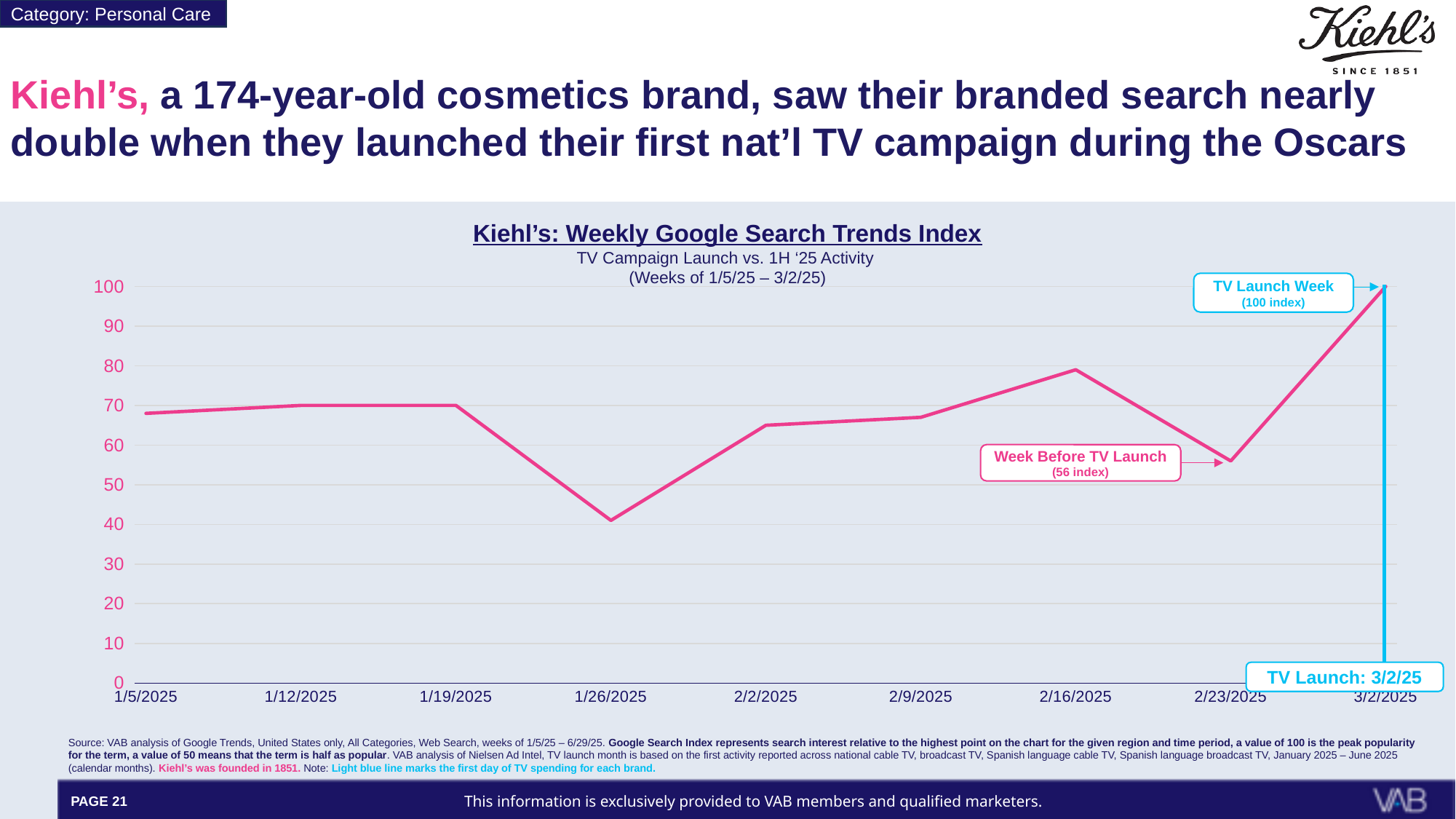
How many weekly data points are plotted on the chart? 9 Which week has a higher index value, 2/16/2025 or 2/23/2025? 2/16/2025 What is the search trends index value for the week of 2/23/2025, the week before the TV launch? 56 By how much did the index rise from the week before the TV launch (2/23/2025) to the TV launch week (3/2/2025)? 44 What is the search trends index value for the week of 3/2/2025? 100 Is the index value for the week of 2/16/2025 greater or less than 70? greater Which week has the highest search trends index value? 3/2/2025 What is the title of the chart? Kiehl's: Weekly Google Search Trends Index Which week has the lowest search trends index value? 1/26/2025 What type of chart is shown on the slide? Line chart Does the index rise or fall between the week of 2/23/2025 and the week of 3/2/2025? Rise Is the index value for the week of 1/26/2025 greater or less than 50? less